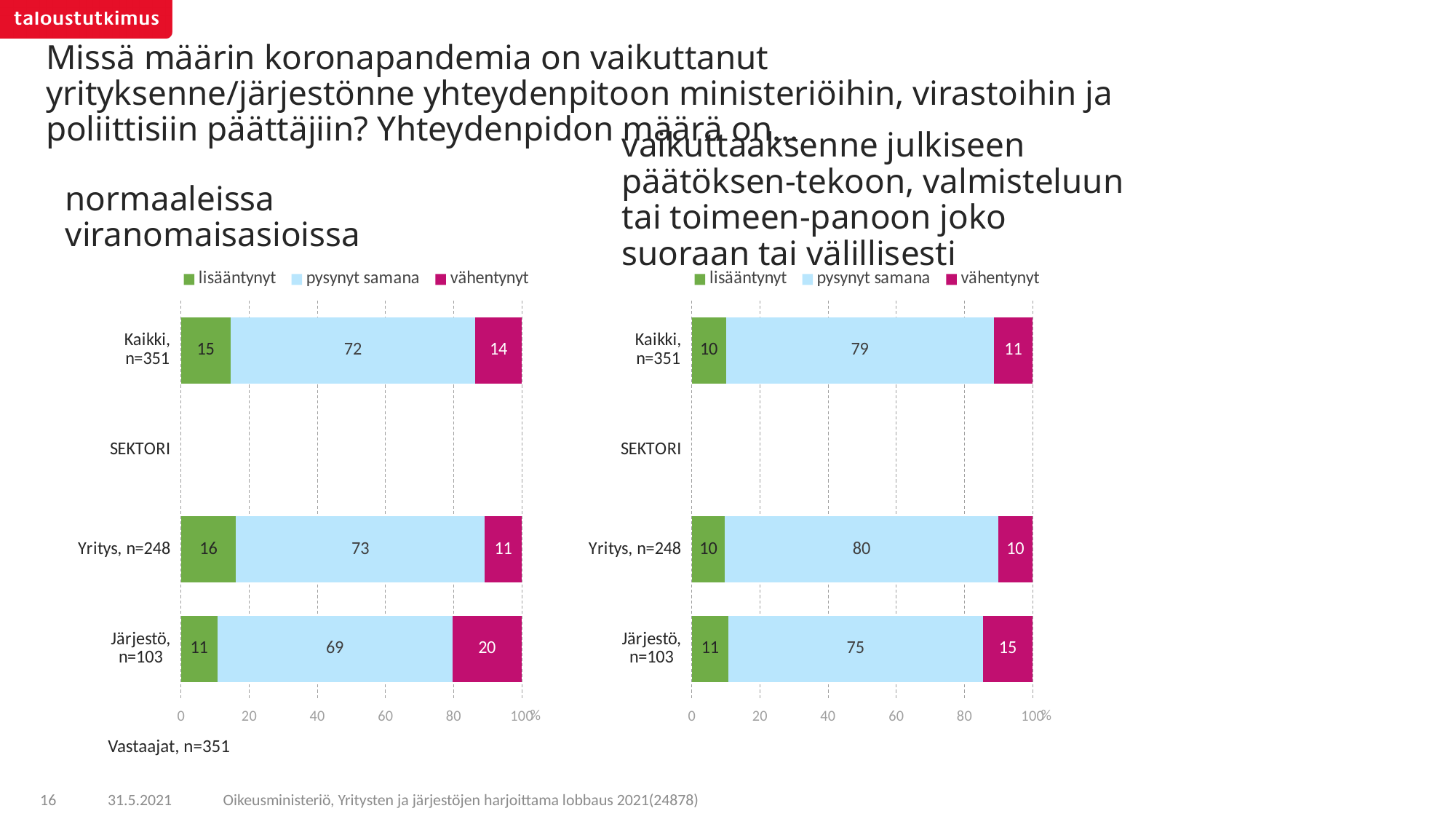
In the left chart (normaaleissa viranomaisasioissa), which colour represents 'vähentynyt'? Magenta (pink-red) In the left chart (normaaleissa viranomaisasioissa), which category has the lowest 'lisääntynyt' value? Järjestö, n=103 In the left chart (normaaleissa viranomaisasioissa), what is the value of 'pysynyt samana' for Kaikki, n=351? 72 What kind of chart is the right chart (vaikuttaaksenne julkiseen päätöksen-tekoon...)? Stacked bar chart In the right chart (vaikuttaaksenne julkiseen päätöksen-tekoon...), what is the value of 'lisääntynyt' for Järjestö, n=103? 11 In the right chart (vaikuttaaksenne julkiseen päätöksen-tekoon...), what is the value of 'pysynyt samana' for Yritys, n=248? 80 In the left chart (normaaleissa viranomaisasioissa), what is the value of 'vähentynyt' for Järjestö, n=103? 20 In the left chart (normaaleissa viranomaisasioissa), is the 'lisääntynyt' value for Yritys, n=248 larger or smaller than the 'vähentynyt' value for Yritys, n=248? larger In the left chart (normaaleissa viranomaisasioissa), which category has the highest 'vähentynyt' value? Järjestö, n=103 In the right chart (vaikuttaaksenne julkiseen päätöksen-tekoon...), what is the total of the stacked bar for Kaikki, n=351? 100 How many series does the legend of the left chart list? 3 In the right chart (vaikuttaaksenne julkiseen päätöksen-tekoon...), what is the difference between the 'vähentynyt' values for Järjestö, n=103 and Yritys, n=248? 5